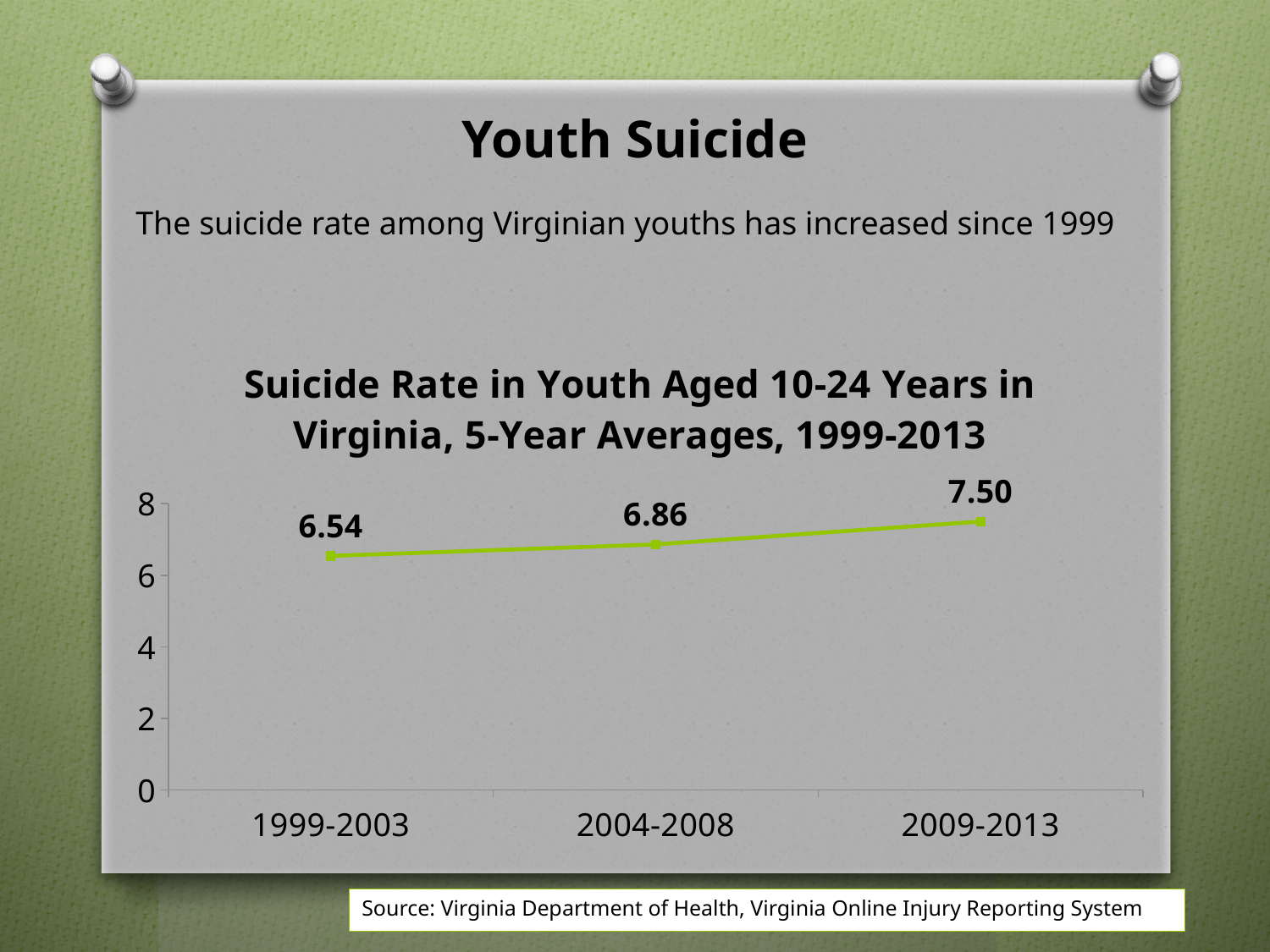
What is the suicide rate for 2004-2008? 6.86 What is the suicide rate for 1999-2003? 6.54 Which is larger, the suicide rate for 2004-2008 or 2009-2013? 2009-2013 What is the difference between the suicide rate for 2009-2013 and 1999-2003? 0.96 What is the suicide rate for 2009-2013? 7.50 Is the value for 2009-2013 greater or less than 8? less Do the values rise or fall from 1999-2003 to 2009-2013? rise Which period has the highest suicide rate? 2009-2013 What kind of chart is shown on the slide? line chart How many periods are plotted on the chart? 3 What is the difference between the suicide rate for 2004-2008 and 1999-2003? 0.32 Which period has the lowest suicide rate? 1999-2003